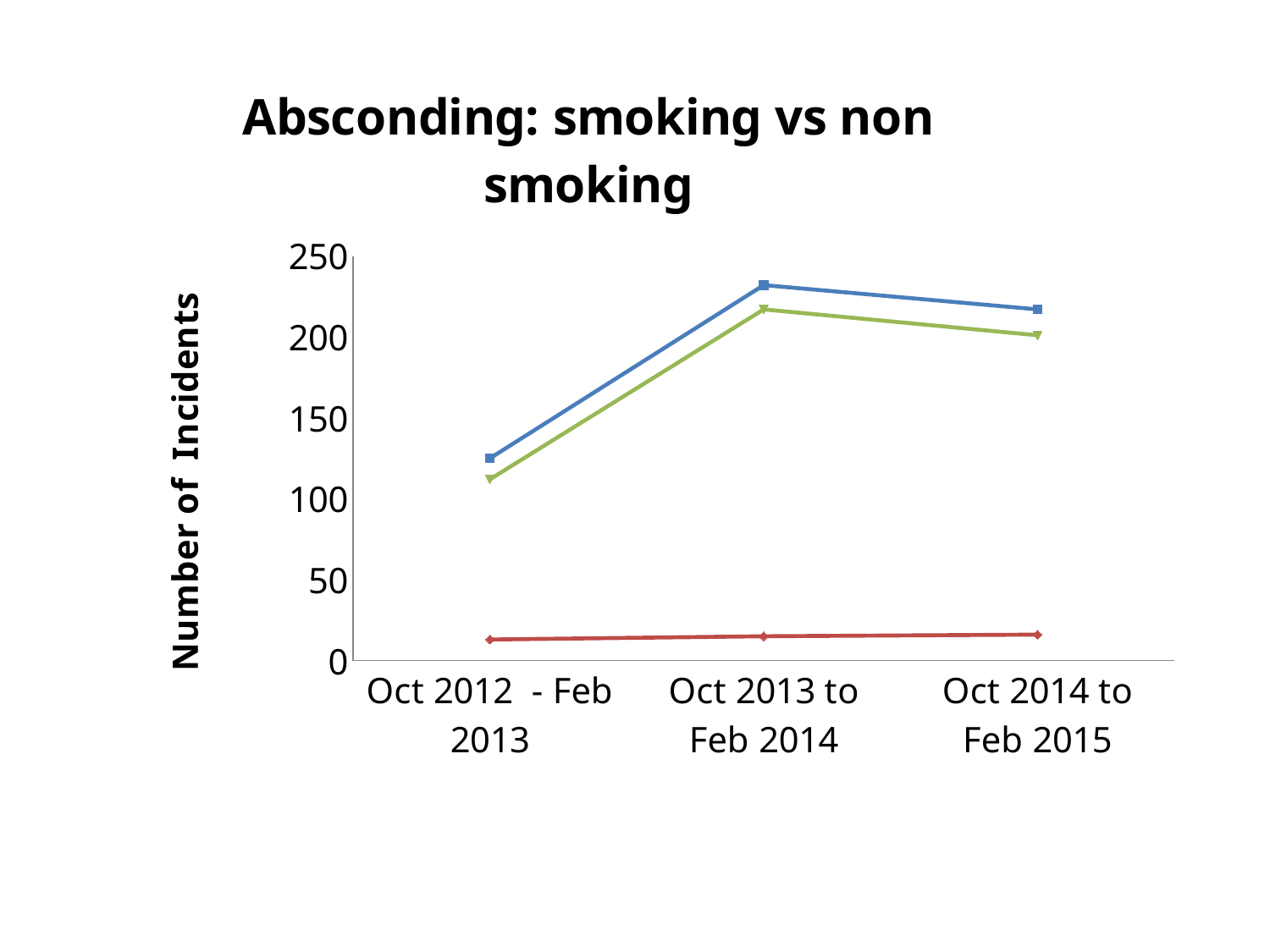
What kind of chart is shown on the slide? line chart Is the value of the blue line for Oct 2013 to Feb 2014 greater or less than 200? greater Is the value of the blue line for Oct 2012 - Feb 2013 greater or less than 100? greater Does the blue line rise or fall from Oct 2012 - Feb 2013 to Oct 2013 to Feb 2014? rise How many time periods are shown on the x axis? 3 Is the value of the red line for Oct 2014 to Feb 2015 greater or less than 50? less In which period is the green line at its lowest value? Oct 2012 - Feb 2013 What is the title of the chart? Absconding: smoking vs non smoking For Oct 2013 to Feb 2014, which line has the larger value, the blue line or the red line? blue line What is the label of the vertical axis? Number of Incidents In which period does the blue line reach its highest value? Oct 2013 to Feb 2014